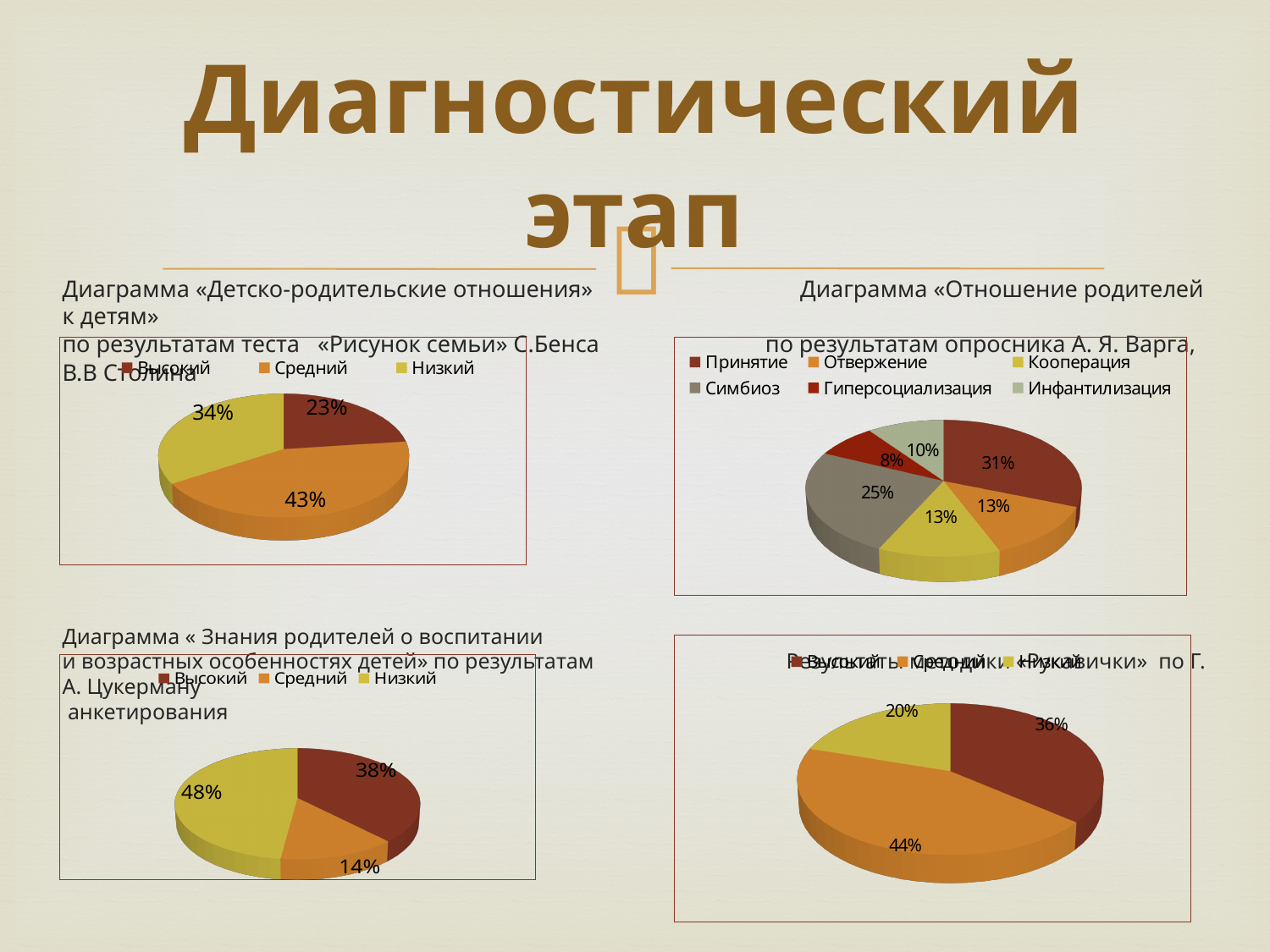
What type of chart is used for all four diagrams on the slide? Pie chart In the bottom-left chart «Знания родителей о воспитании и возрастных особенностях детей», which is larger: Высокий or Низкий? Низкий In the top-right chart «Отношение родителей к детям», what percentage is shown for Принятие? 31% In the bottom-left chart «Знания родителей о воспитании и возрастных особенностях детей», what percentage is shown for Средний? 14% How many categories does the legend of the top-right chart «Отношение родителей к детям» list? 6 In the top-left chart «Детско-родительские отношения», what percentage is shown for Средний? 43% In the bottom-left chart «Знания родителей о воспитании и возрастных особенностях детей», which category has the largest share? Низкий In the top-left chart «Детско-родительские отношения», what is the difference between the Средний and Низкий shares? 9% In the bottom-right chart «Результаты методики «Рукавички»», what is the largest percentage shown? 44% In the top-left chart «Детско-родительские отношения», which category has the smallest share? Высокий In the top-right chart «Отношение родителей к детям», what percentage is shown for Симбиоз? 25% In the top-right chart «Отношение родителей к детям», which category has the smallest share? Гиперсоциализация